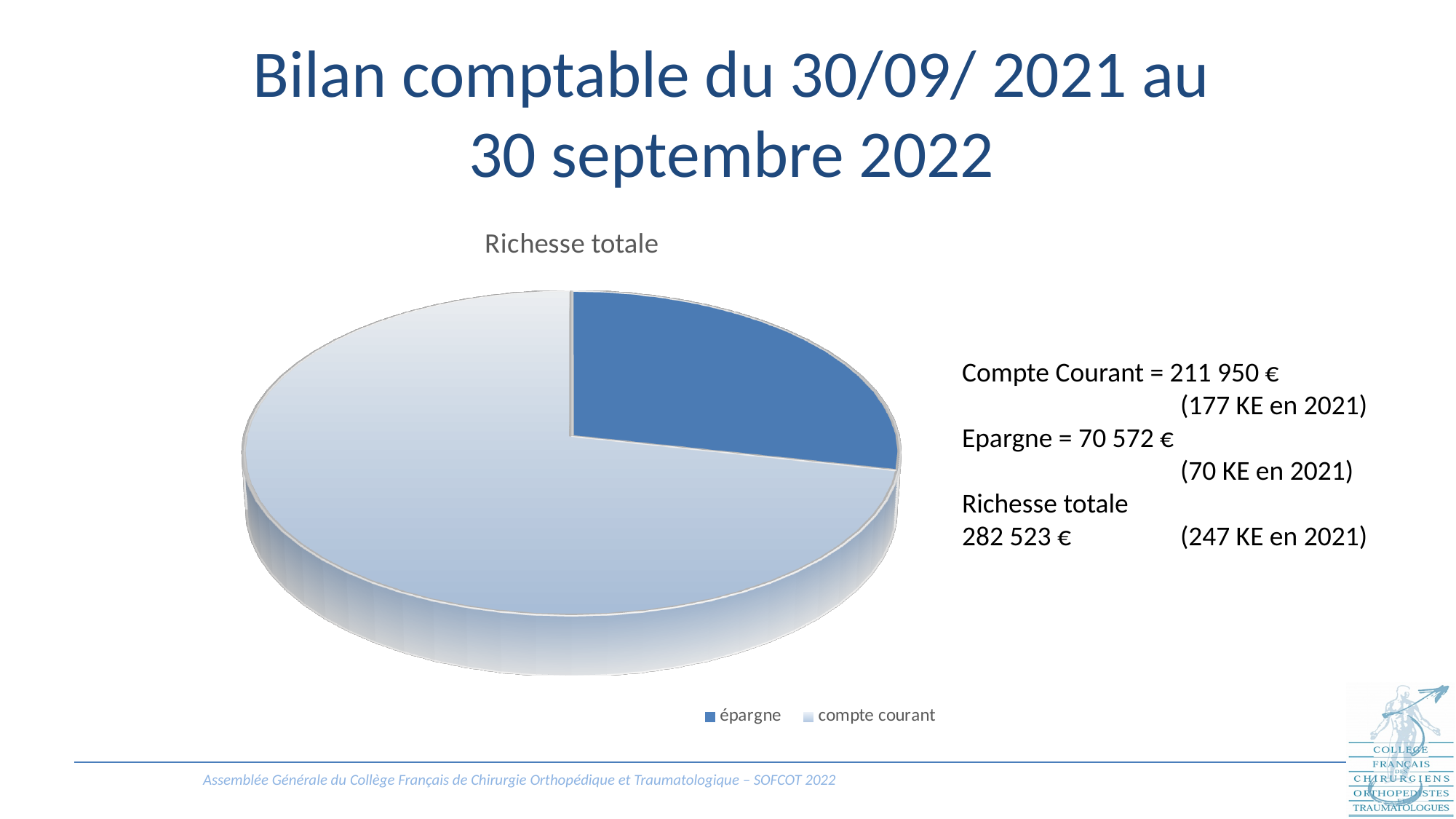
What is the title of the chart? Richesse totale What is the Richesse totale (total of the two slices) as printed on the slide? 282 523 € What is the value of the Compte Courant as printed on the slide? 211 950 € What kind of chart is shown on the slide? pie chart Which category has the largest slice of the pie? compte courant How many slices does the pie chart have? 2 Which category has the smallest slice of the pie? épargne Which colour represents épargne in the pie chart? dark blue What is the value of the Epargne as printed on the slide? 70 572 € Which is larger, the épargne slice or the compte courant slice? compte courant What is the difference between the Compte Courant and the Epargne values? 141 378 € How many entries does the chart legend list? 2